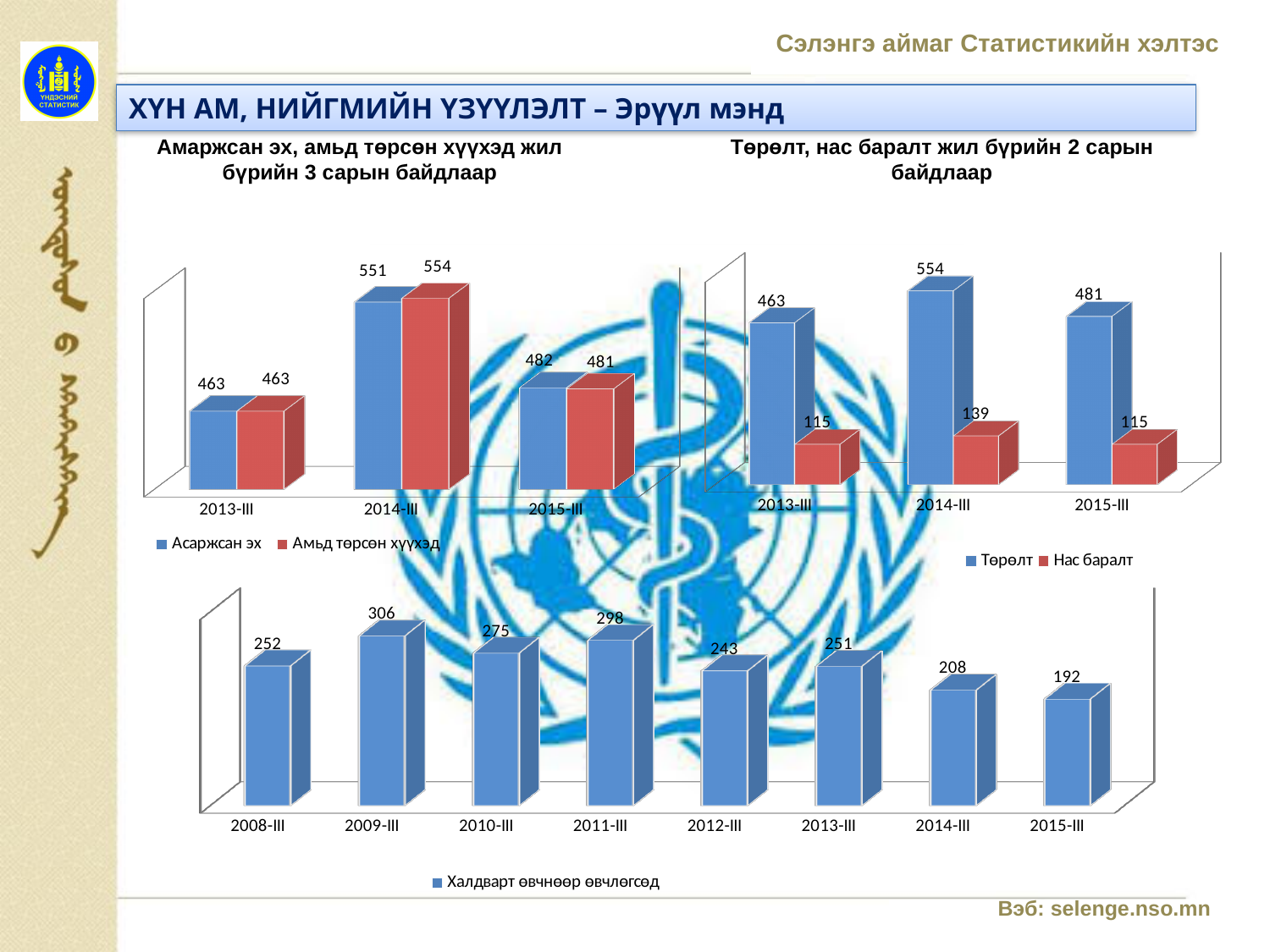
In the bottom chart (Халдварт өвчнөөр өвчлөгсөд), what is the value for 2011-III? 298 In the top-left chart (Амаржсан эх, амьд төрсөн хүүхэд), how many series does the legend list? 2 In the bottom chart (Халдварт өвчнөөр өвчлөгсөд), which year has the lowest value? 2015-III In the bottom chart (Халдварт өвчнөөр өвчлөгсөд), how many years are shown on the x axis? 8 In the bottom chart (Халдварт өвчнөөр өвчлөгсөд), which year has the highest value? 2009-III In the top-right chart (Төрөлт, нас баралт), what is the value of Нас баралт for 2014-III? 139 In the top-right chart (Төрөлт, нас баралт), is Төрөлт for 2015-III larger or smaller than Нас баралт for 2015-III? larger In the top-right chart (Төрөлт, нас баралт), which year has the highest Төрөлт value? 2014-III In the top-left chart (Амаржсан эх, амьд төрсөн хүүхэд), what is the value of Асаржсан эх for 2015-III? 482 In the top-left chart (Амаржсан эх, амьд төрсөн хүүхэд), what is the value of Амьд төрсөн хүүхэд for 2014-III? 554 What kind of chart is the bottom chart (Халдварт өвчнөөр өвчлөгсөд)? bar chart In the top-right chart (Төрөлт, нас баралт), what is the difference between Төрөлт and Нас баралт for 2013-III? 348